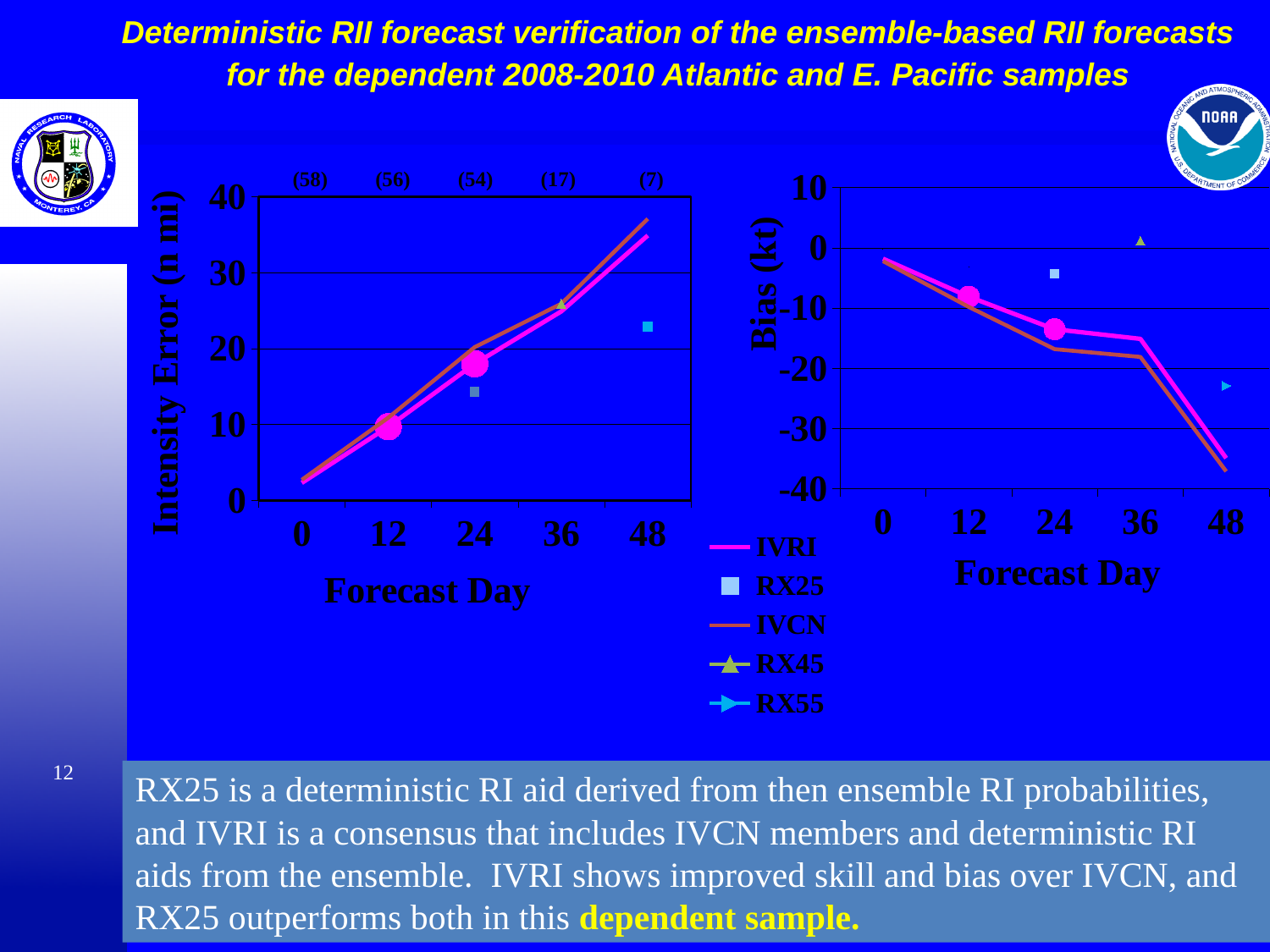
How many series does the legend list? 5 In the right chart, is the IVCN bias at forecast day 48 greater or less than -30? less What sample size is printed above forecast day 48 in the left chart? (7) In the right chart (Bias), do the IVRI and IVCN lines rise or fall as forecast day increases? fall In the left chart, is the RX25 intensity error at forecast day 24 greater or less than 20? less What kind of chart is the left chart (Intensity Error)? line chart In the left chart, is the IVCN intensity error at forecast day 48 greater or less than 30? greater In the left chart (Intensity Error), do the IVRI and IVCN lines rise or fall as forecast day increases? rise How many forecast day ticks are shown on the x axis of the left chart? 5 In the right chart at forecast day 24, which has the higher bias value, RX25 or IVRI? RX25